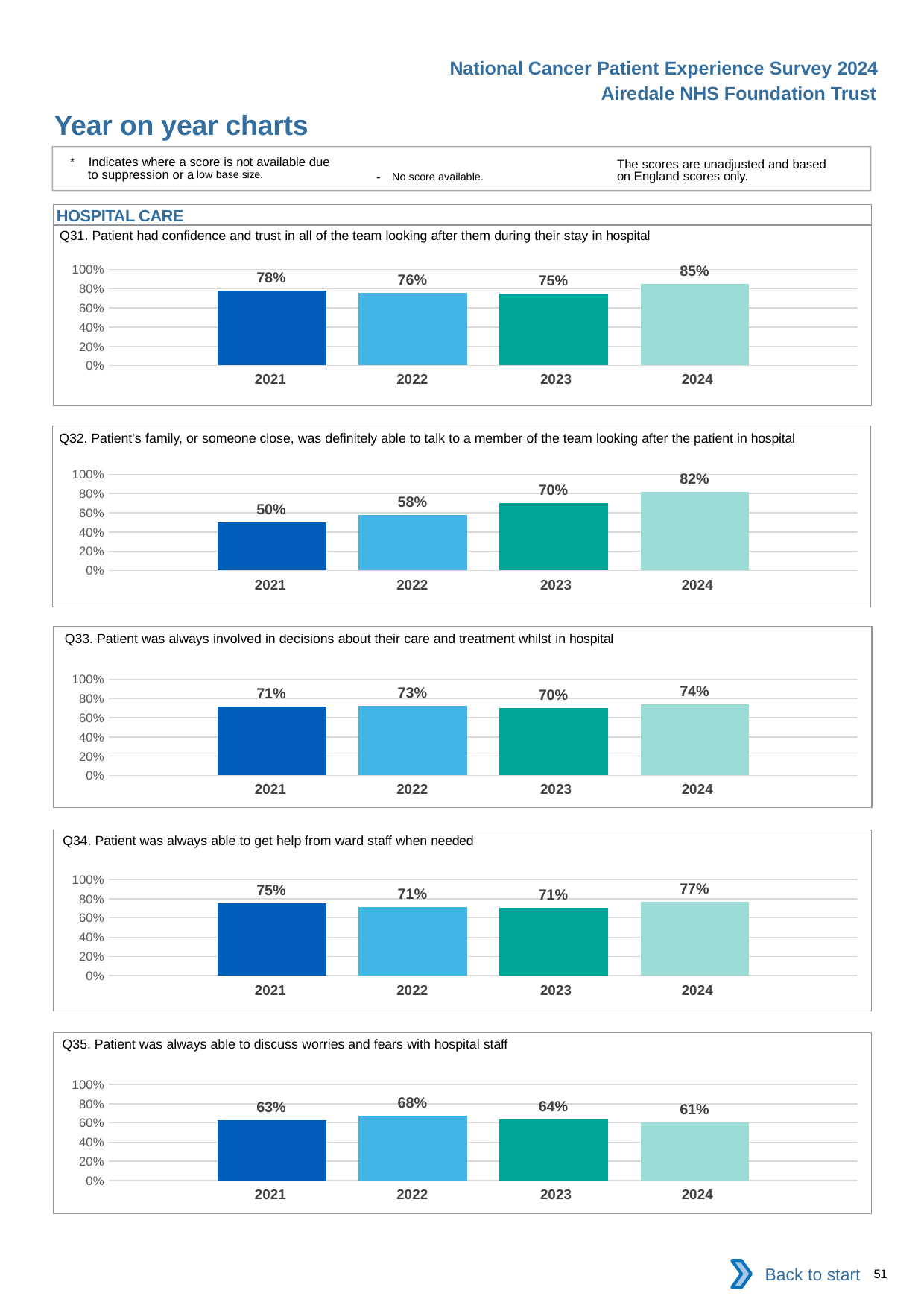
In the Q31 chart, what is the value for 2024? 85% In the Q33 chart, which year has the highest value? 2024 In the Q34 chart, what is the value for 2022? 71% In the Q35 chart, what is the value for 2021? 63% How many charts are shown under the HOSPITAL CARE heading on the slide? 5 In the Q32 chart, do the values rise or fall from 2021 to 2024? rise How many years are shown in the Q31 chart? 4 In the Q35 chart, which is larger, the value for 2022 or the value for 2024? 2022 In the Q31 chart, what is the difference between the 2024 and 2023 values? 10 percentage points What kind of chart is the Q34 chart? bar chart In the Q32 chart, what is the difference between the 2024 and 2021 values? 32 percentage points In the Q32 chart, which year has the lowest value? 2021